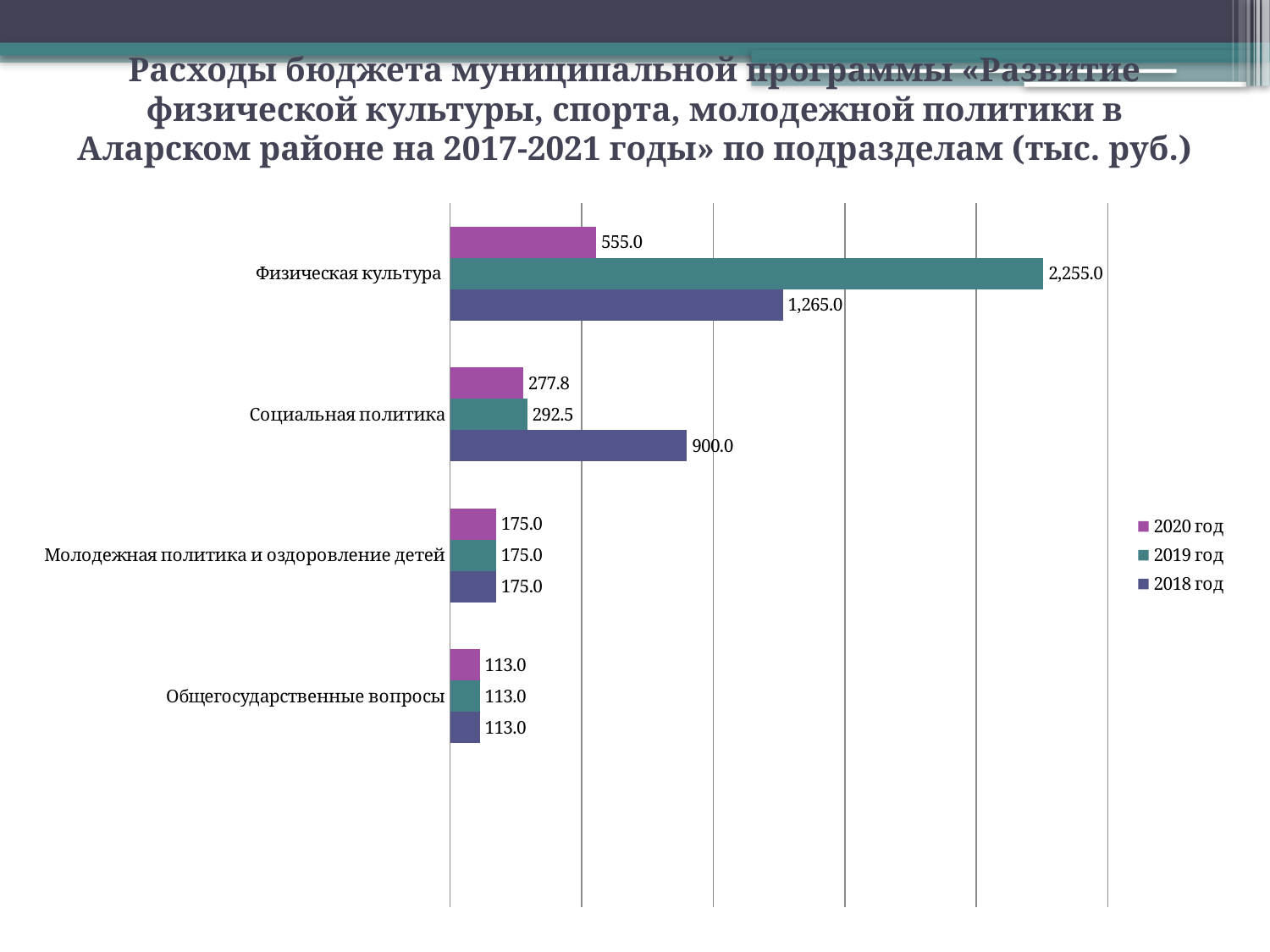
Which category has the highest value in 2018 год? Физическая культура How many series does the legend list? 3 What is the difference between the 2018 год and 2020 год values for Социальная политика? 622.2 What is the value for Физическая культура in 2019 год? 2,255.0 What kind of chart is shown on the slide? Bar chart Which category has the lowest value in 2020 год? Общегосударственные вопросы Which is larger for Социальная политика: the 2020 год value or the 2019 год value? 2019 год How many categories are shown on the chart? 4 What is the value for Социальная политика in 2018 год? 900.0 What is the value for Физическая культура in 2020 год? 555.0 Which series is shown in purple (magenta) in the legend? 2020 год What is the difference between the 2019 год and 2018 год values for Физическая культура? 990.0